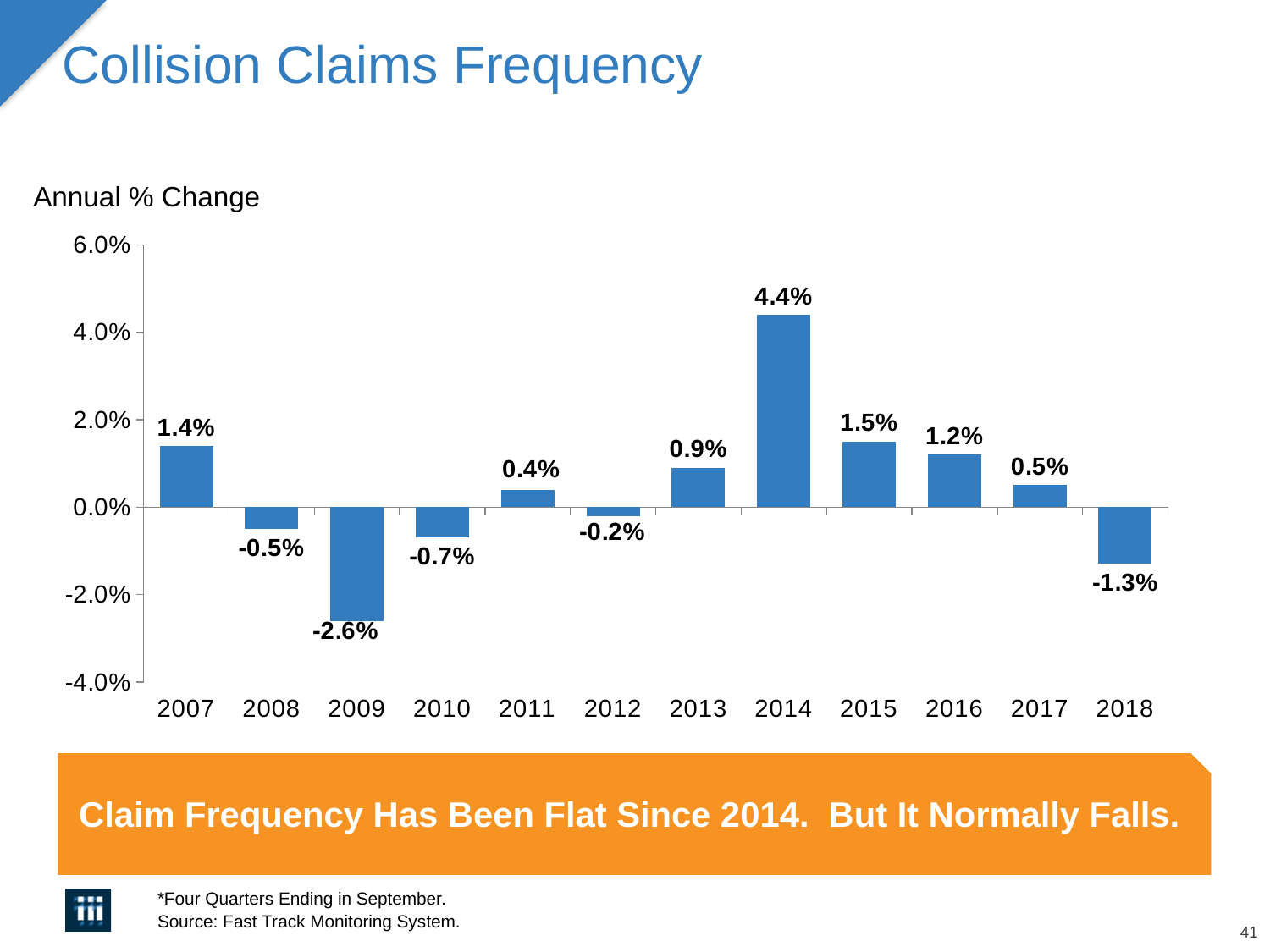
Do the values rise or fall from 2014 to 2018? Fall Which year has the larger annual % change, 2013 or 2016? 2016 Which year has the lowest annual % change? 2009 What is the annual % change in collision claims frequency for 2014? 4.4% Is the value for 2014 greater or less than 4.0%? greater What kind of chart is shown on the slide? Bar chart What is the annual % change shown for 2018? -1.3% What is the label above the chart describing the measure plotted? Annual % Change What is the difference between the 2014 value and the 2015 value? 2.9% Which year has the highest annual % change? 2014 How many years are shown on the x axis? 12 What is the annual % change shown for 2009? -2.6%